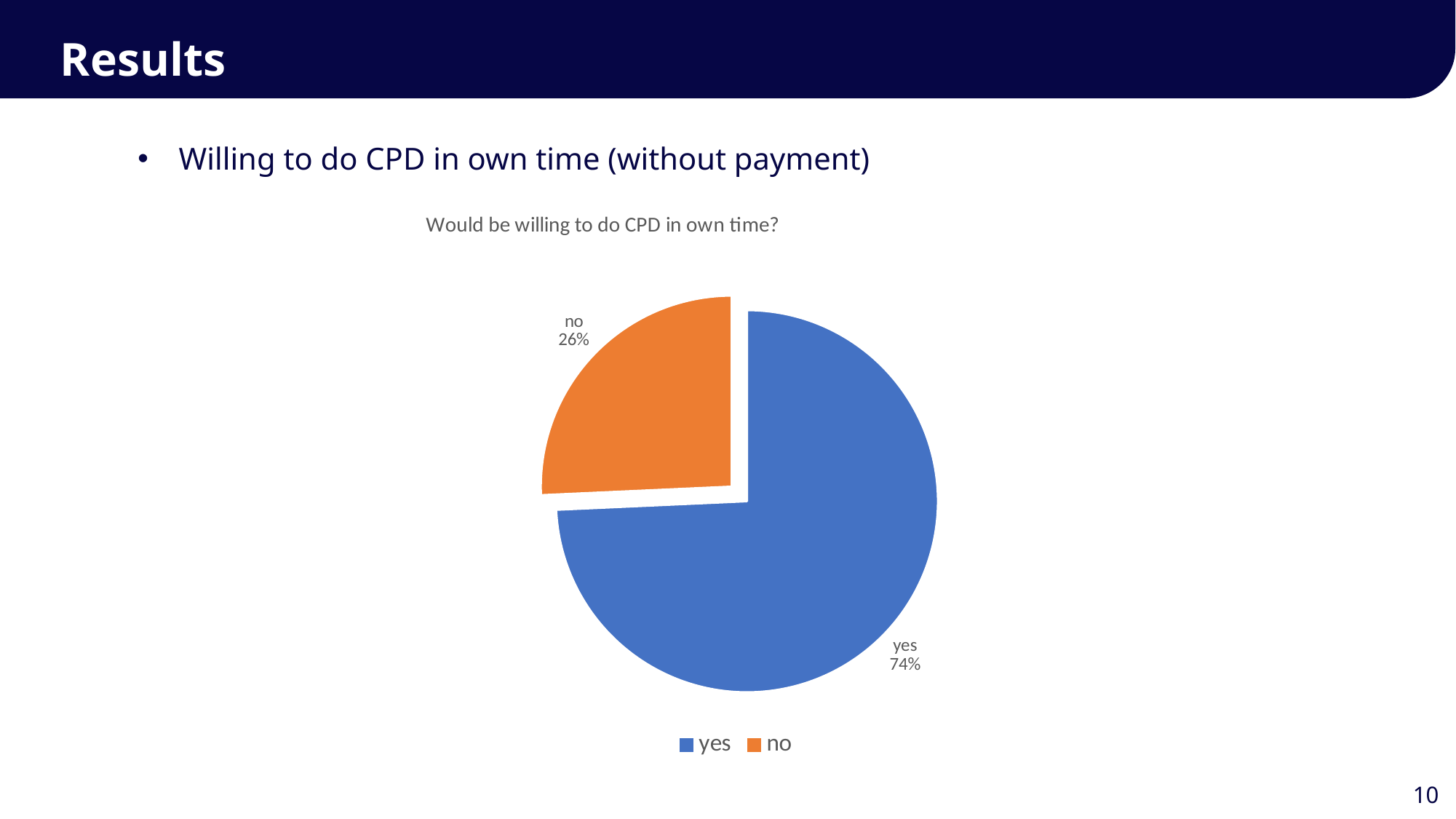
What type of chart is shown on the slide? pie chart What percentage of respondents answered "no"? 26% How many entries does the legend list? 2 What share of the pie does the "yes" slice represent? 74% What is the difference in percentage points between the "yes" and "no" slices? 48 Which category has the smallest share of the pie? no What colour is the "no" slice? orange Which is larger, the "yes" slice or the "no" slice? yes How many slices does the pie chart have? 2 Which category has the largest share of the pie? yes What percentage of respondents answered "yes"? 74% What is the title of the chart? Would be willing to do CPD in own time?